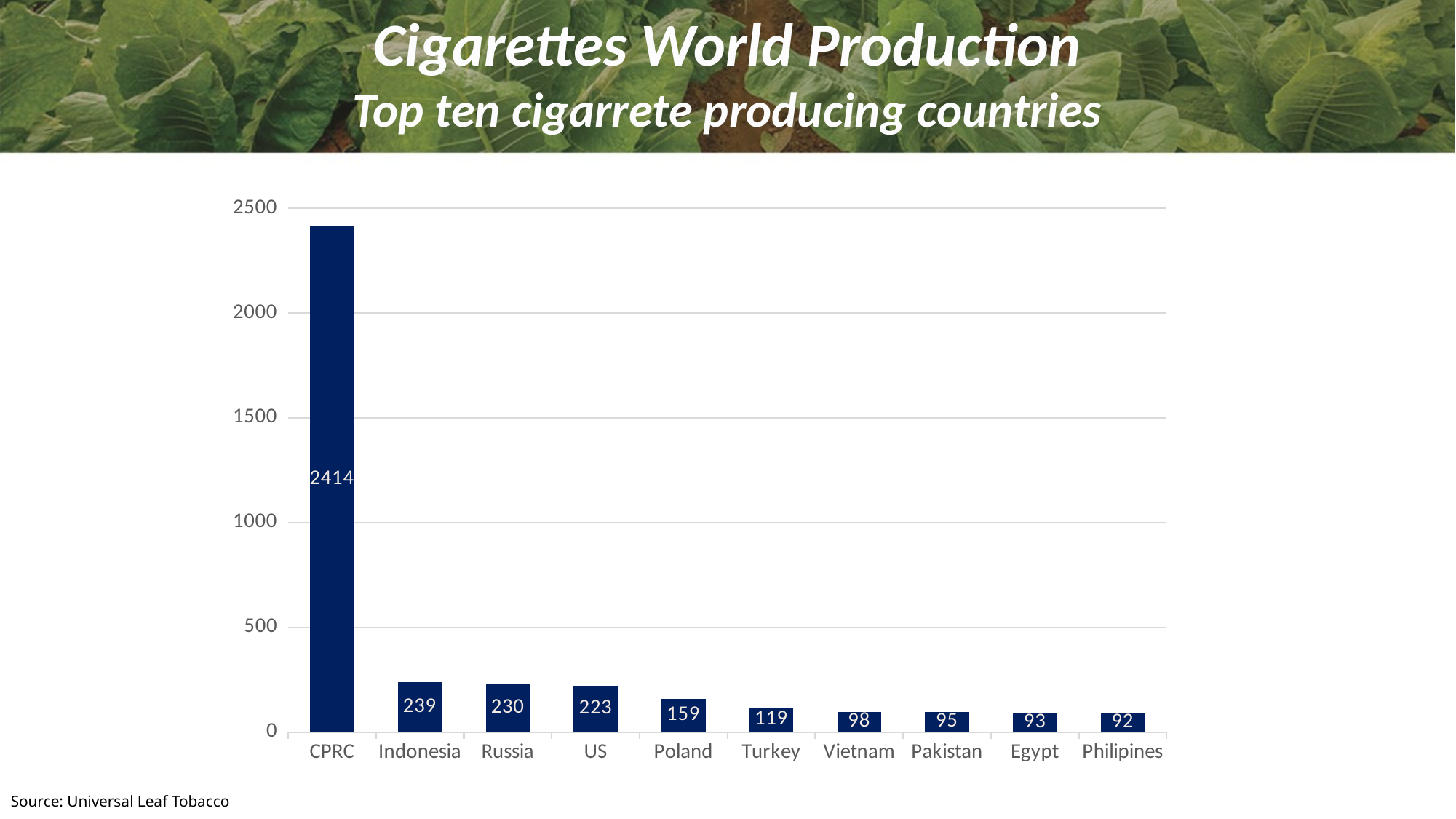
What is the difference between the values for Russia and US? 7 What is the value for Philipines? 92 What is the value for Poland? 159 Which is larger, the value for Turkey or the value for Vietnam? Turkey What is the value for CPRC? 2414 Which country has the lowest value? Philipines What is the difference between the values for CPRC and Indonesia? 2175 What is the value for Indonesia? 239 Which country has the highest value? CPRC Is the value for CPRC greater or less than 2000? greater How many countries are shown in the chart? 10 What kind of chart is shown on the slide? bar chart